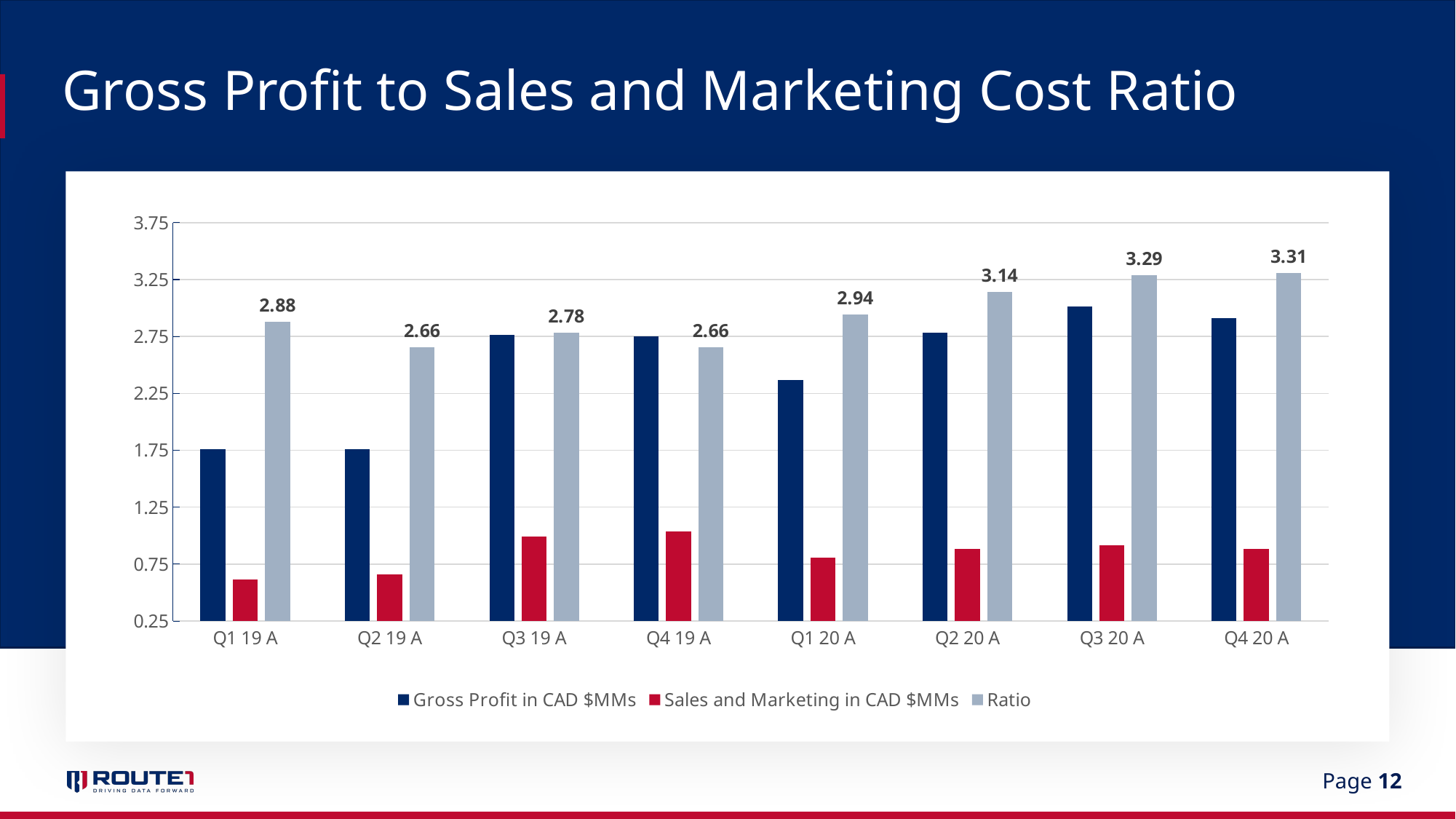
Which quarter has the highest Ratio value? Q4 20 A Is the Gross Profit in CAD $MMs value for Q3 20 A greater or less than 2.75? greater How many series does the legend list? 3 Does the Ratio rise or fall from Q1 20 A to Q4 20 A? rise What is the difference between the Ratio for Q4 20 A and the Ratio for Q1 19 A? 0.43 What is the Ratio value for Q2 20 A? 3.14 How many quarters are shown on the x axis? 8 Is the Sales and Marketing in CAD $MMs value for Q1 19 A greater or less than 0.75? less What is the Ratio value for Q1 19 A? 2.88 Which has a higher Ratio, Q3 19 A or Q1 20 A? Q1 20 A What is the Ratio value for Q4 20 A? 3.31 What is the lowest Ratio value shown on the chart? 2.66